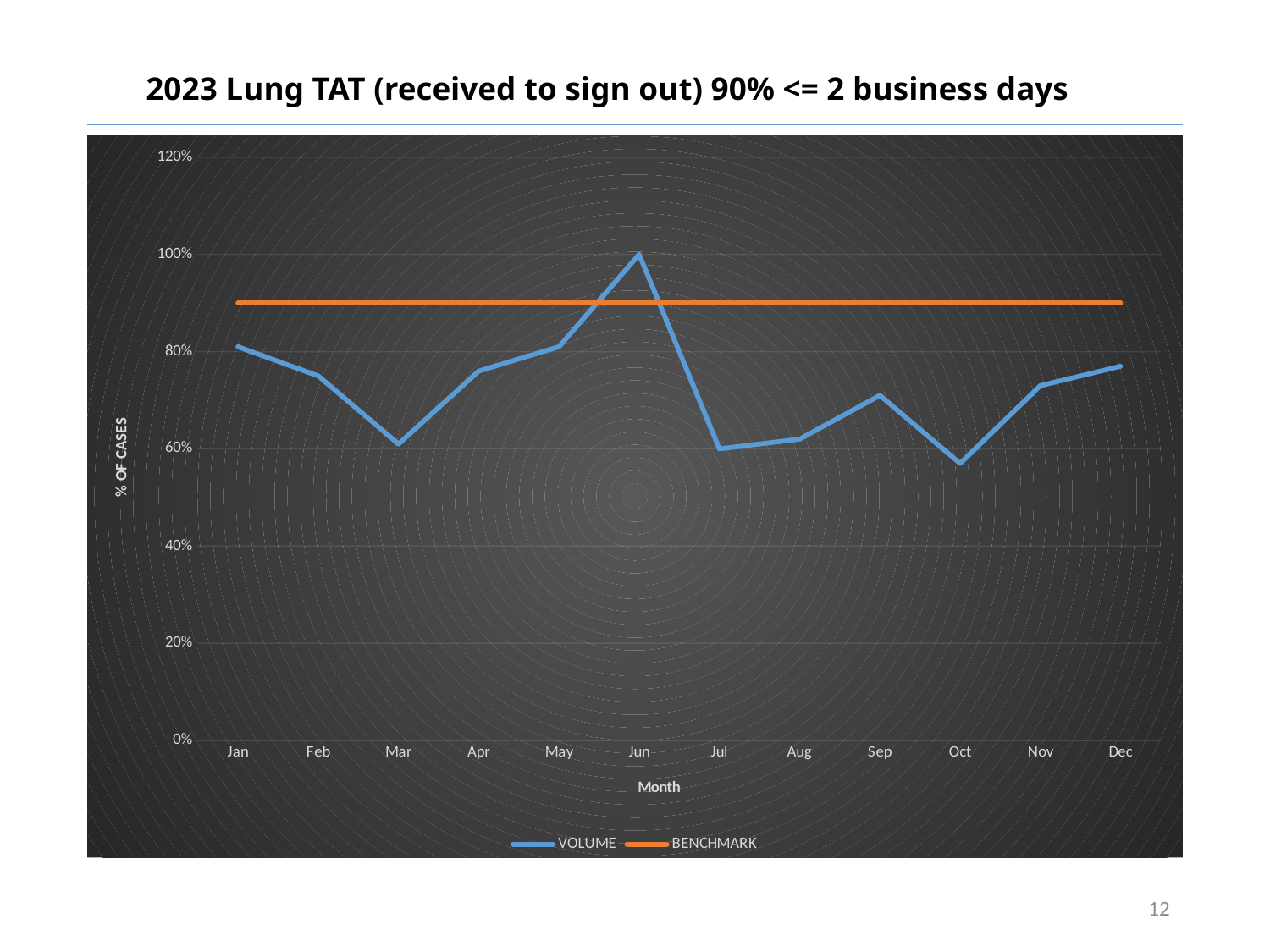
Is the VOLUME value for Sep greater or less than 60%? greater How many series does the legend list? 2 In which month does the VOLUME series reach its lowest value? Oct What is the title of the chart? 2023 Lung TAT (received to sign out) 90% <= 2 business days In which month does the VOLUME series reach its highest value? Jun What kind of chart is shown on the slide? line chart What is the VOLUME value for Jun? 100% Is the VOLUME value for Mar greater or less than 80%? less How many months are plotted along the x axis? 12 Which month has the larger VOLUME value, Aug or Sep? Sep Does the VOLUME series rise or fall from Jun to Jul? fall Is the BENCHMARK line above or below 80%? above